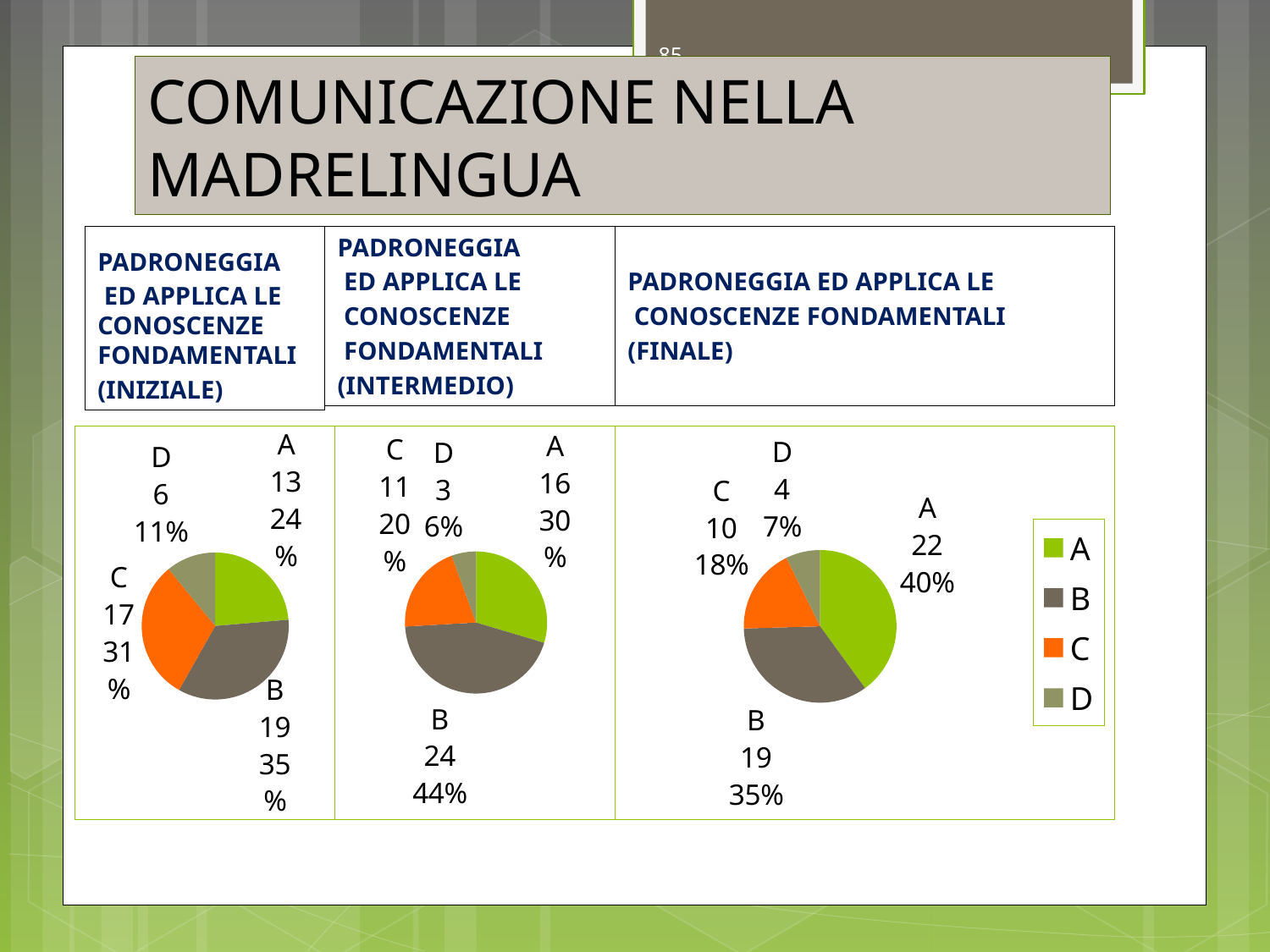
In the INIZIALE pie chart (left), what percentage share does category C have? 31% In the FINALE pie chart (right), what percentage share does category A have? 40% In the INTERMEDIO pie chart (middle), which category has the largest slice? B What type of chart is used for the three charts on the slide? Pie chart How many entries does the legend on the right of the slide list? 4 In the INTERMEDIO pie chart (middle), what is the value for category A? 16 In the INTERMEDIO pie chart (middle), which category has the smallest slice? D How many categories does each pie chart on the slide show? 4 In the FINALE pie chart (right), what is the difference between the values for A and B? 3 In the INIZIALE pie chart (left), what is the value for category B? 19 In the INIZIALE pie chart (left), which is larger, the value for B or the value for C? B In the FINALE pie chart (right), what is the value for category D? 4